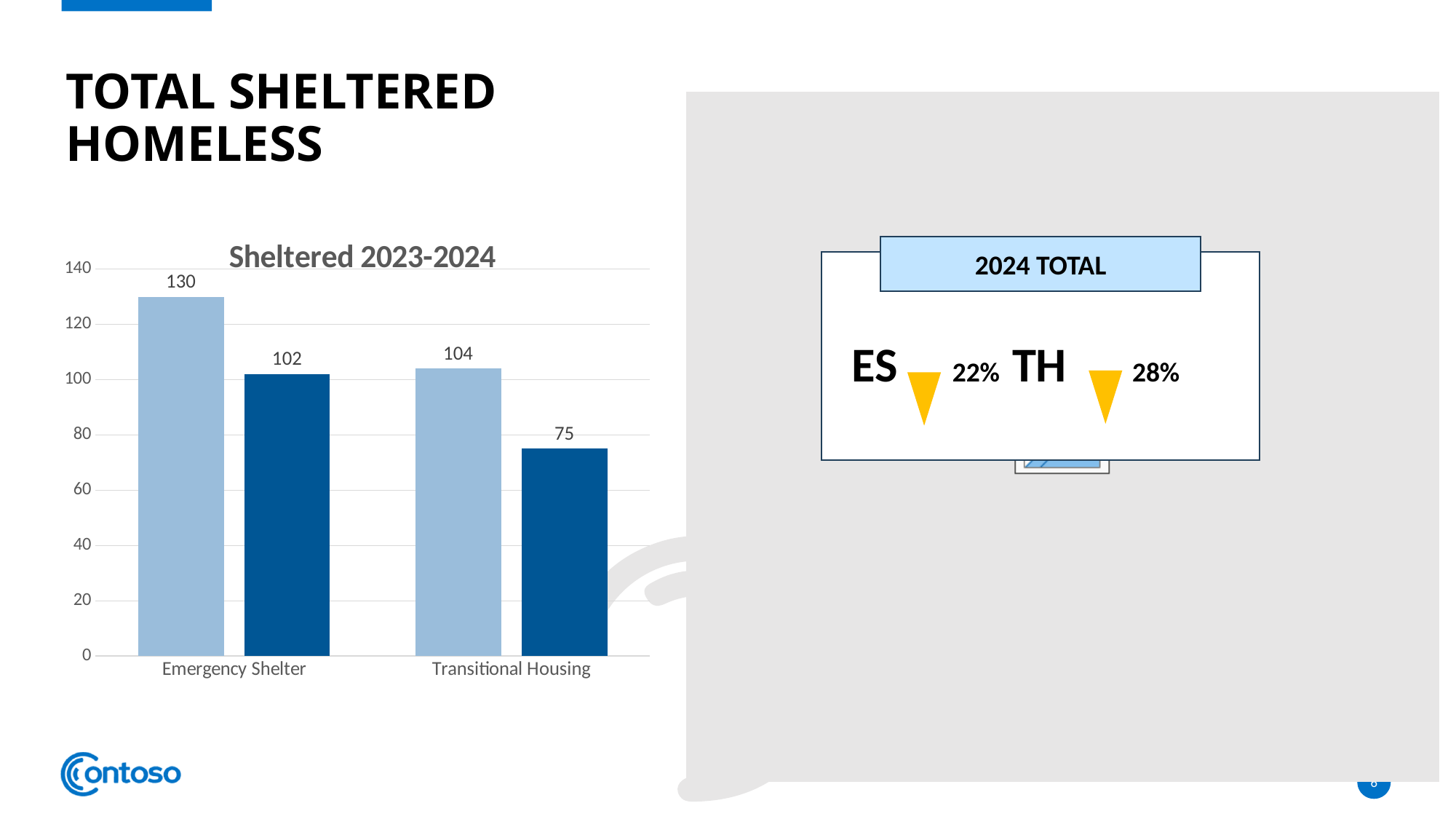
What is the value of the light blue bar for Emergency Shelter? 130 Which bar in the chart has the lowest value? Transitional Housing (dark blue bar) Which bar in the chart has the highest value? Emergency Shelter (light blue bar) What is the value of the dark blue bar for Transitional Housing? 75 What is the difference between the light blue and dark blue bars for Transitional Housing? 29 Which is larger: the dark blue bar for Emergency Shelter or the light blue bar for Transitional Housing? Light blue bar for Transitional Housing What is the difference between the light blue and dark blue bars for Emergency Shelter? 28 What kind of chart is shown on the slide? Bar chart How many categories are shown on the x axis of the chart? 2 What is the value of the light blue bar for Transitional Housing? 104 What is the title of the chart? Sheltered 2023-2024 What is the value of the dark blue bar for Emergency Shelter? 102